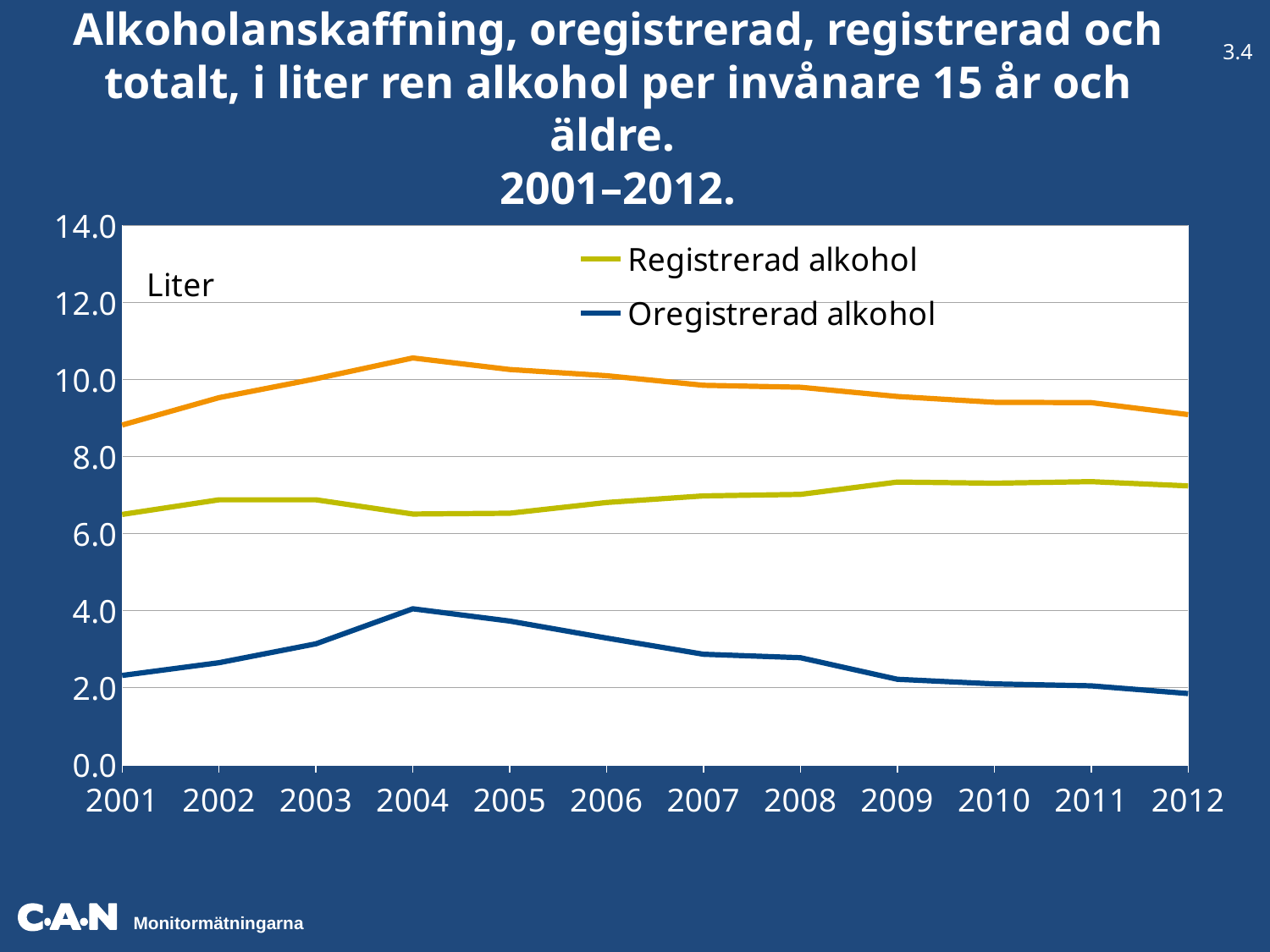
Is the value of the orange line in 2004 greater or less than 10.0? greater Is the value for Registrerad alkohol in 2009 greater or less than 7.0? greater In which year is the value for Oregistrerad alkohol lowest? 2012 Is the value of the orange line in 2012 greater or less than 10.0? less How many series does the legend list? 2 What kind of chart is shown on the slide? line chart What unit label is shown at the top of the y axis? Liter How many years are shown on the x axis? 12 Which is larger in 2004, Registrerad alkohol or Oregistrerad alkohol? Registrerad alkohol In which year is the value for Oregistrerad alkohol highest? 2004 Does the value for Oregistrerad alkohol rise or fall from 2004 to 2012? fall